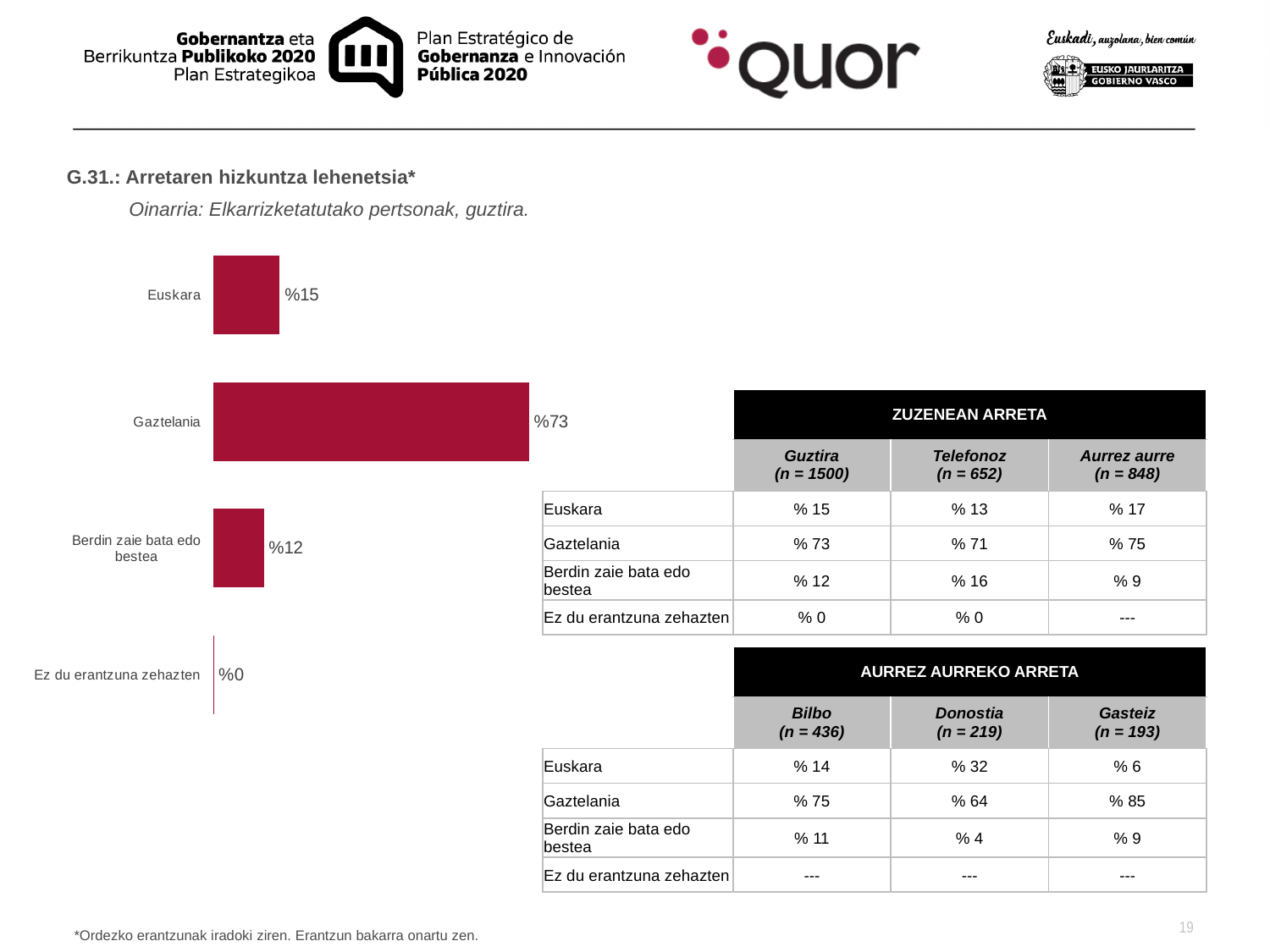
What is the title of the chart on the slide? G.31.: Arretaren hizkuntza lehenetsia* What value does the bar chart show for Euskara? %15 What is the difference between the values for Euskara and Berdin zaie bata edo bestea in the bar chart? %3 What is the difference between the values for Gaztelania and Euskara in the bar chart? %58 What type of chart is shown on the slide? bar chart What value does the bar chart show for Gaztelania? %73 What value does the bar chart show for Berdin zaie bata edo bestea? %12 Which category has the highest value in the bar chart? Gaztelania In the bar chart, which is larger: the value for Euskara or the value for Berdin zaie bata edo bestea? Euskara Which category has the lowest value in the bar chart? Ez du erantzuna zehazten How many categories are shown in the bar chart? 4 What value does the bar chart show for Ez du erantzuna zehazten? %0